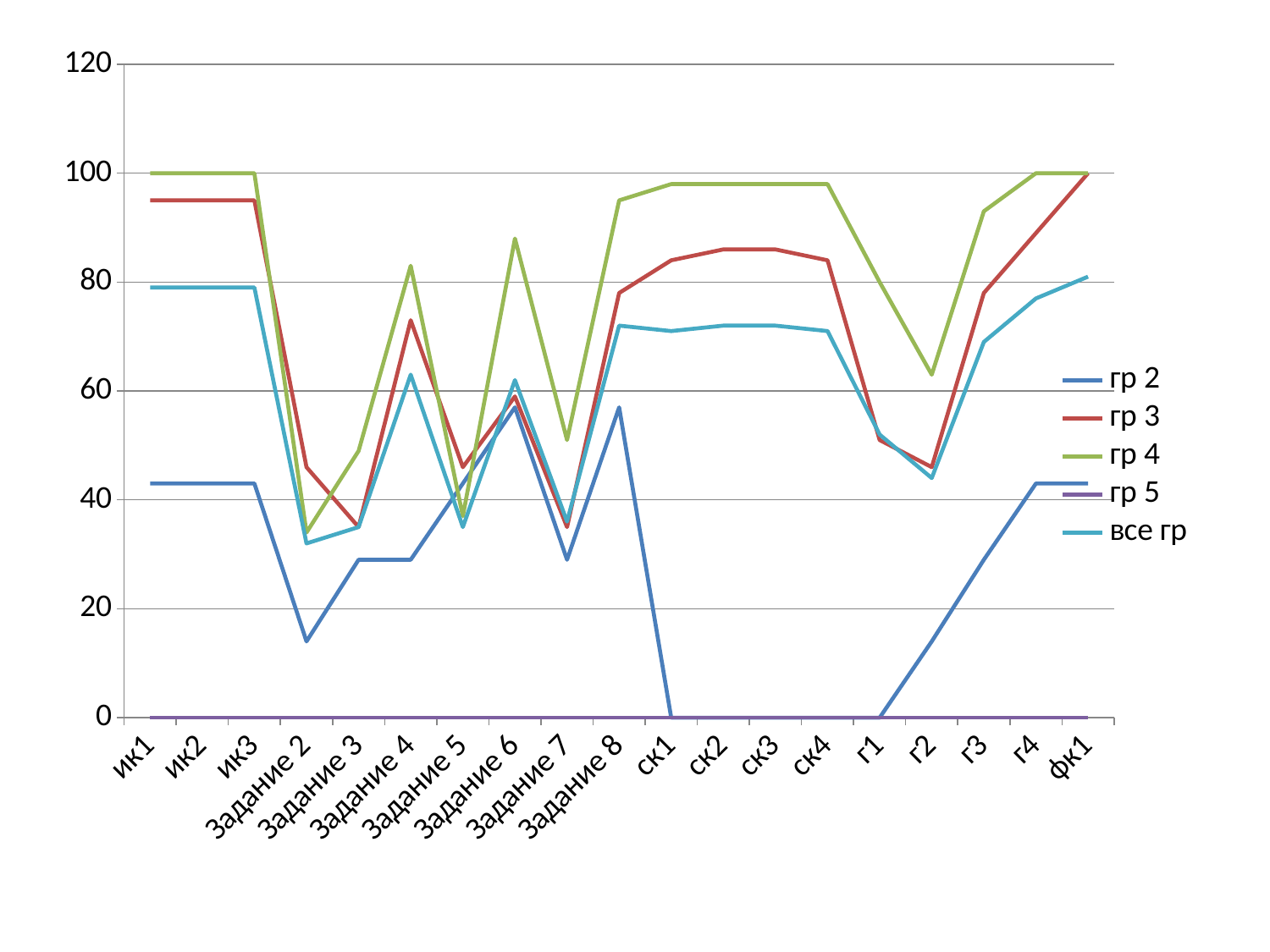
Which series has the highest value at ик1? гр 4 What is the value of гр 3 at фк1? 100 How many series does the legend list? 5 Is the value for гр 3 at ск2 greater or less than 80? greater Which series has the lowest value at ик1? гр 5 What kind of chart is shown on the slide? line chart Which is larger at ик1, гр 3 or гр 2? гр 3 What is the value of гр 5 at ск1? 0 What is the value of гр 4 at ик1? 100 How many categories are shown along the x axis? 19 Is the value for гр 2 at Задание 2 greater or less than 20? less What is the value of гр 2 at ск1? 0